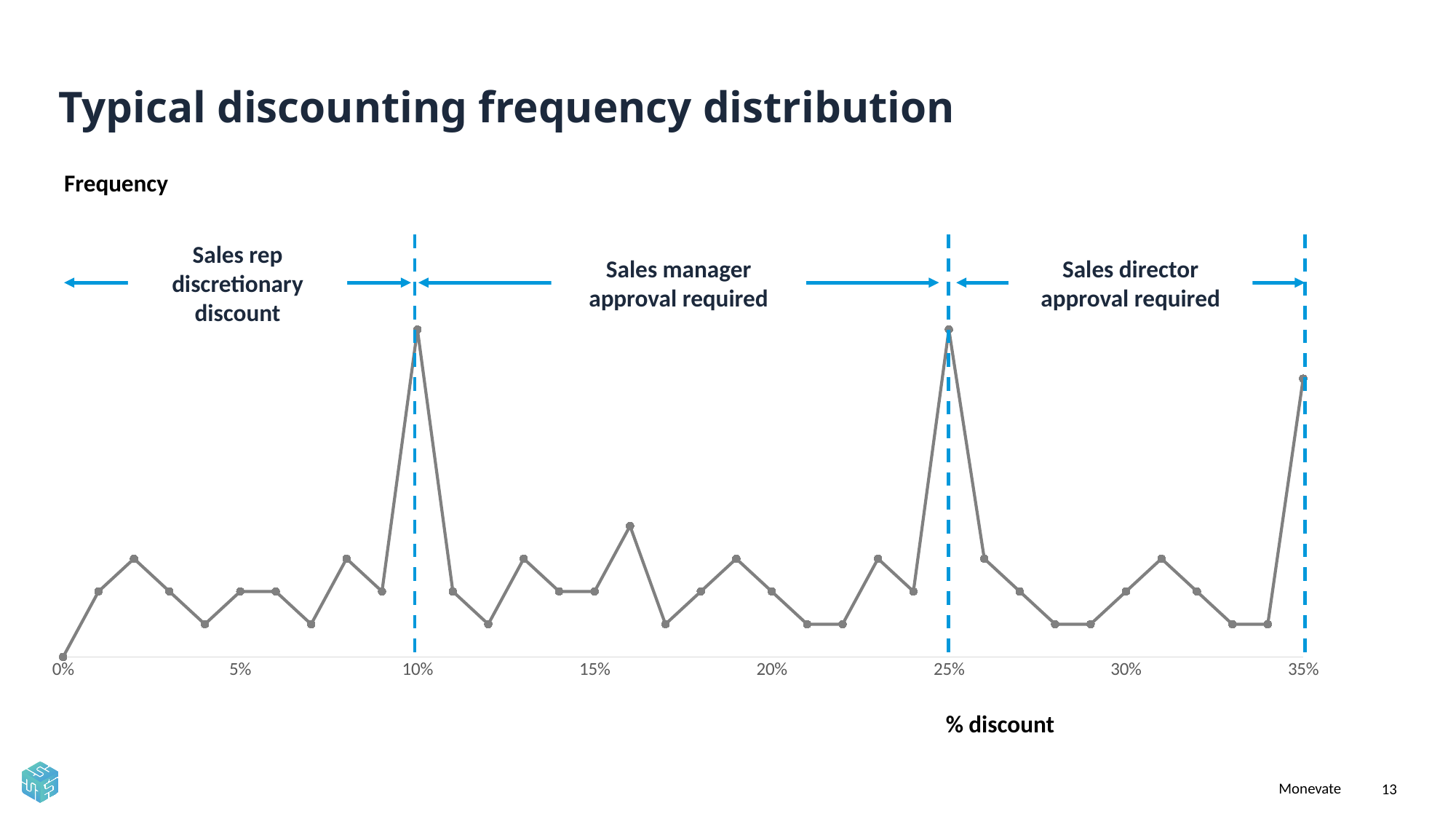
Which has the higher frequency, the point at 2% discount or the point at 4% discount? 2% Which has the higher frequency, the point at 35% discount or the point at 34% discount? 35% Does the frequency rise or fall between 25% discount and 28% discount? fall How many data points are plotted on the line? 36 Which has the higher frequency, the point at 25% discount or the point at 26% discount? 25% Does the frequency rise or fall between 9% discount and 10% discount? rise What is the title of the chart? Typical discounting frequency distribution What is the label on the x axis of the chart? % discount What kind of chart is shown on the slide? line chart At which % discount is the frequency lowest? 0%